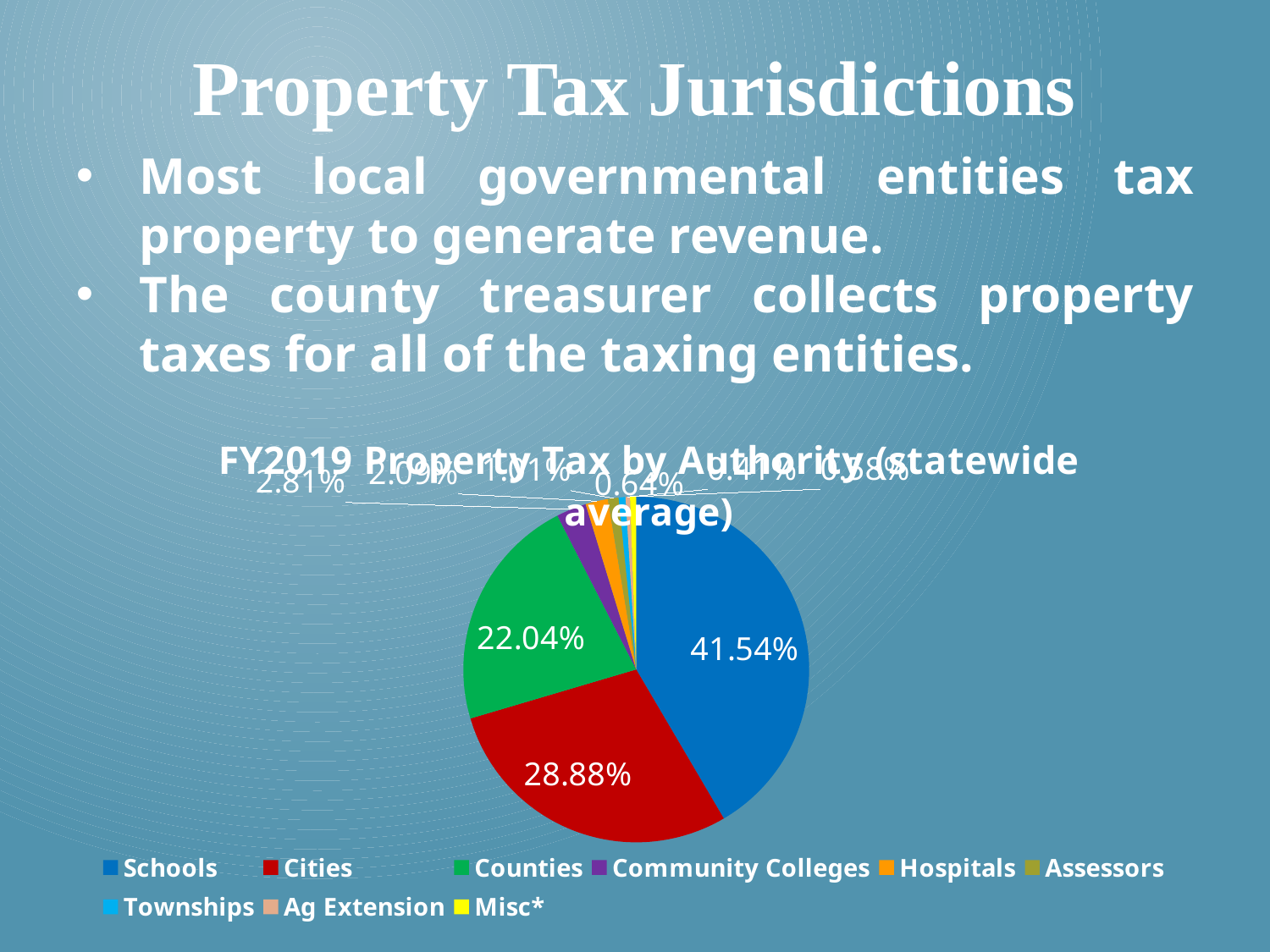
Which authority has the largest share of property tax? Schools What is the difference between the Schools share and the Cities share? 12.66% What is the difference between the Cities share and the Counties share? 6.84% What is the combined share of Schools, Cities and Counties? 92.46% What is the title of the chart? FY2019 Property Tax by Authority (statewide average) Which colour represents Cities in the pie chart? Red What share of property tax goes to Schools? 41.54% Which is larger, the share for Cities or the share for Counties? Cities What is the value for Counties? 22.04% How many authorities are listed in the legend? 9 What type of chart is shown on the slide? Pie chart What is the value for Cities? 28.88%